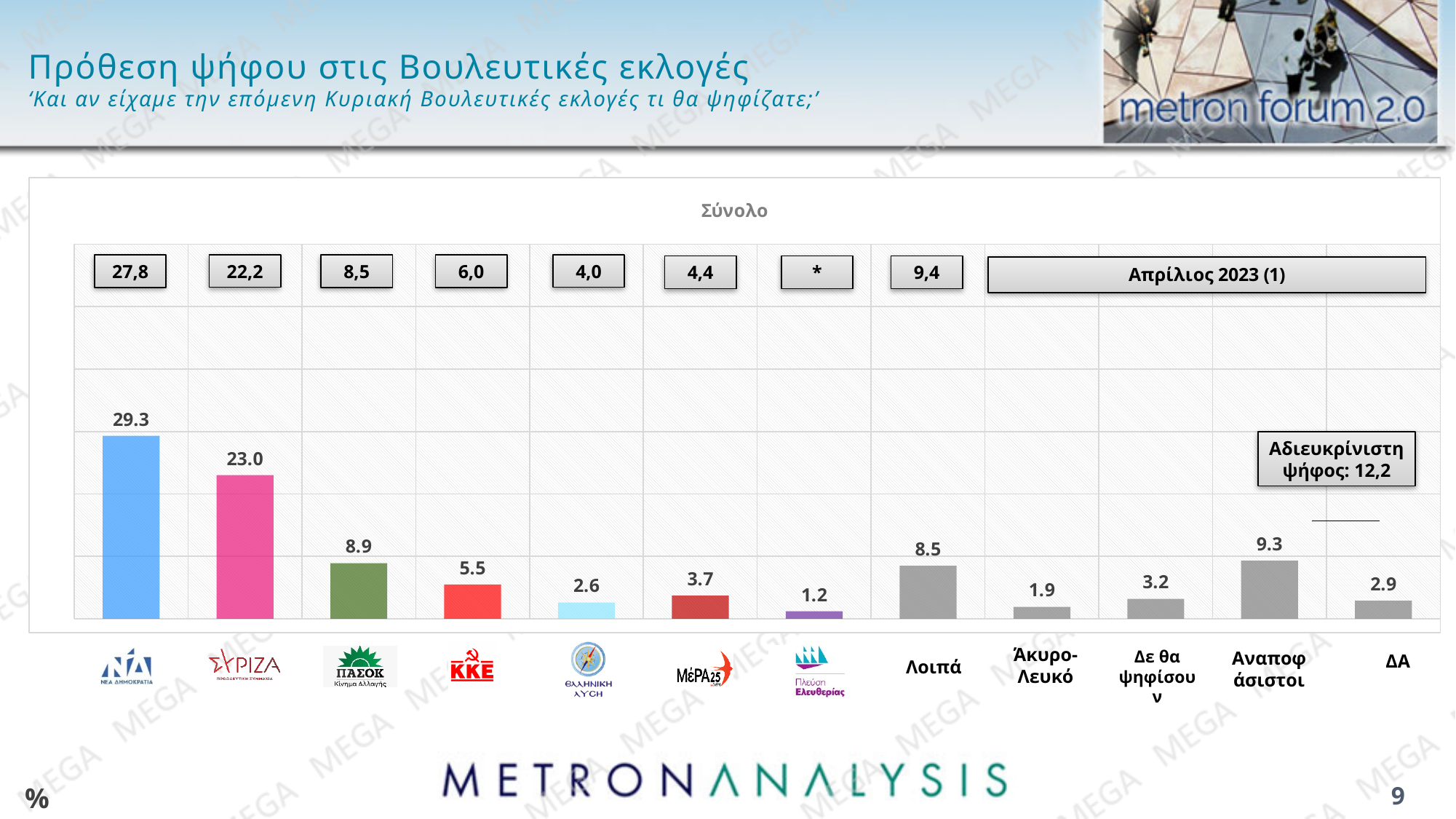
What value is shown in the box for ΝΔ for Απρίλιος 2023 (1)? 27,8 What is the value shown for ΝΕΑ ΔΗΜΟΚΡΑΤΙΑ (ΝΔ) in the chart? 29.3 What is the value shown for ΣΥΡΙΖΑ in the chart? 23.0 Which category has the lowest value in the chart? Πλεύση Ελευθερίας What is the difference between the values for ΝΔ and ΣΥΡΙΖΑ? 6.3 Which category has the highest value in the chart? ΝΕΑ ΔΗΜΟΚΡΑΤΙΑ (ΝΔ) Which has a larger value, ΚΚΕ or ΜέΡΑ25? ΚΚΕ What kind of chart is shown on the slide? Bar chart How many bars are plotted in the chart? 12 What is the value given for Αδιευκρίνιστη ψήφος on the slide? 12,2 What is the value shown for Αναποφάσιστοι in the chart? 9.3 What is the value shown for ΠΑΣΟΚ in the chart? 8.9